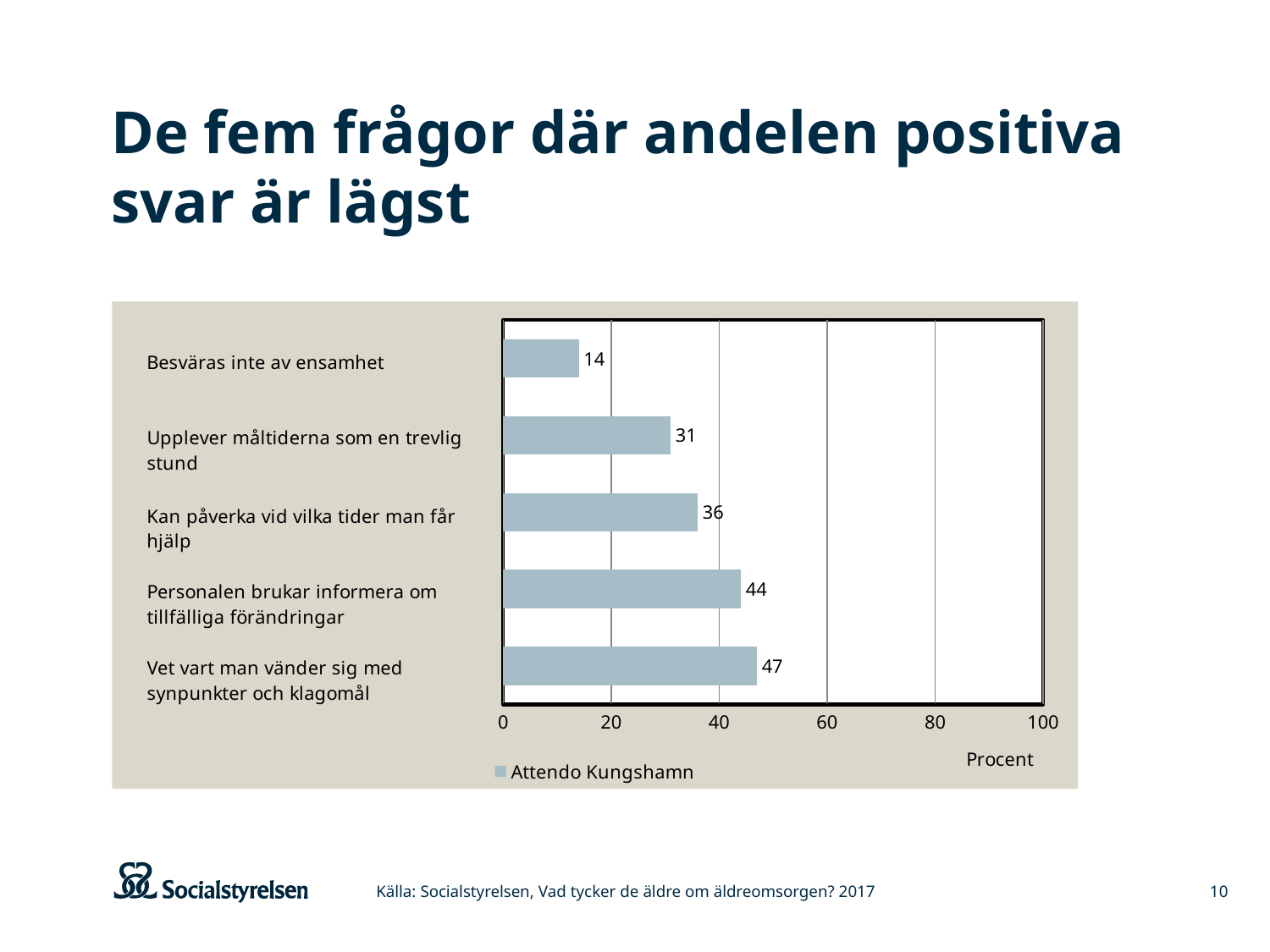
How many categories are shown in the chart? 5 How many series does the legend list? 1 Is the value for "Personalen brukar informera om tillfälliga förändringar" greater or less than 40? greater What is the name of the series shown in the legend? Attendo Kungshamn What is the value for "Vet vart man vänder sig med synpunkter och klagomål"? 47 Which is larger: the value for "Kan påverka vid vilka tider man får hjälp" or the value for "Upplever måltiderna som en trevlig stund"? Kan påverka vid vilka tider man får hjälp Which category has the highest value? Vet vart man vänder sig med synpunkter och klagomål Which category has the lowest value? Besväras inte av ensamhet What kind of chart is shown on the slide? Bar chart What is the difference between the values for "Personalen brukar informera om tillfälliga förändringar" and "Upplever måltiderna som en trevlig stund"? 13 What is the value for "Besväras inte av ensamhet"? 14 What is the value for "Kan påverka vid vilka tider man får hjälp"? 36